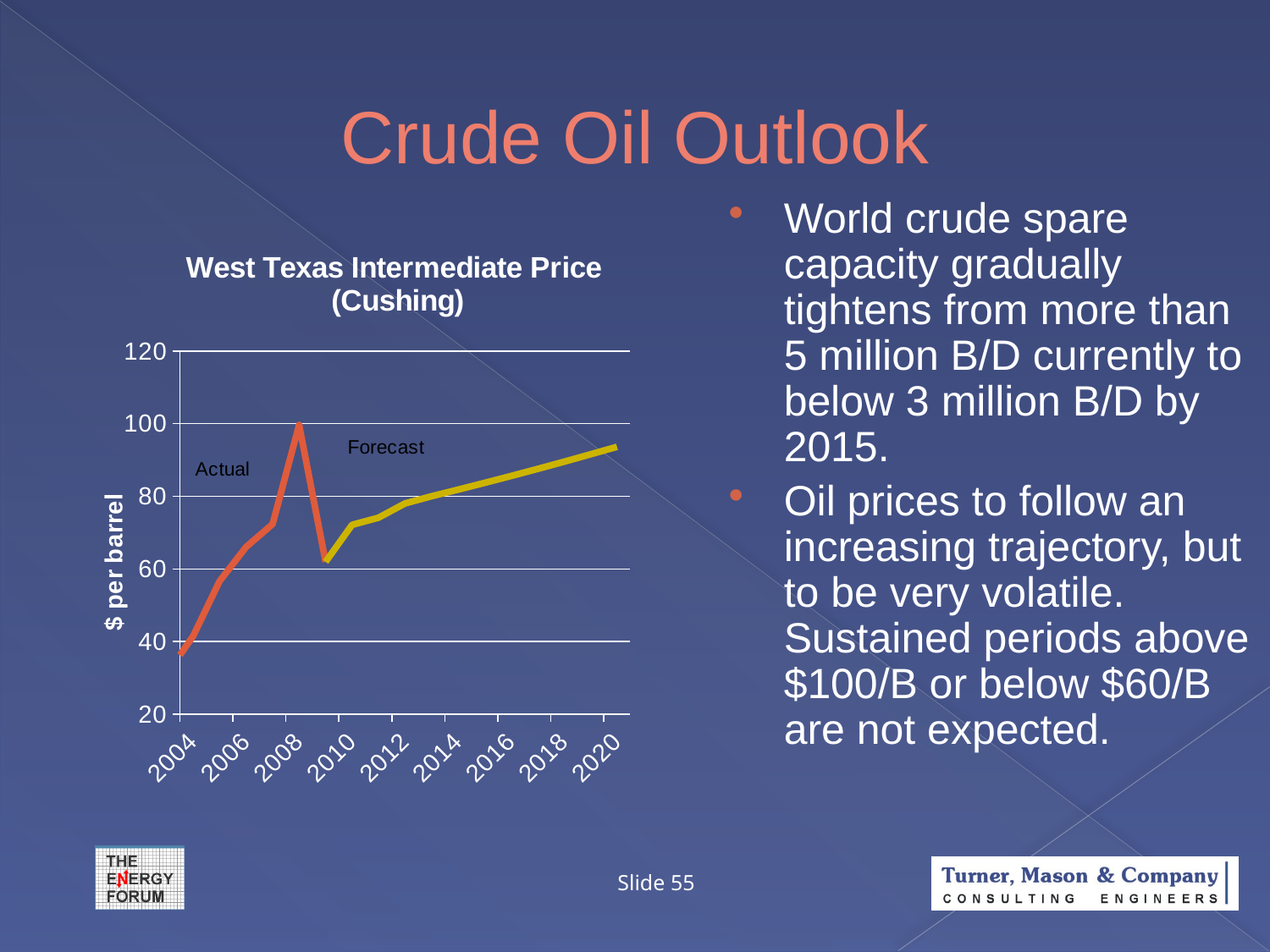
What is the label on the vertical axis of the chart? $ per barrel Is the value for 2020 greater or less than 80? greater What is the title of the chart? West Texas Intermediate Price (Cushing) Does the Forecast portion of the line rise or fall from 2010 to 2020? rise Is the value for 2010 greater or less than 80? less In which year does the West Texas Intermediate price reach its highest point on the chart? 2008 Is the value for 2004 greater or less than 60? less Which is larger, the value for 2008 or the value for 2012? 2008 What kind of chart is shown on the slide? line chart In which year is the West Texas Intermediate price lowest on the chart? 2004 Which is larger, the value for 2010 or the value for 2020? 2020